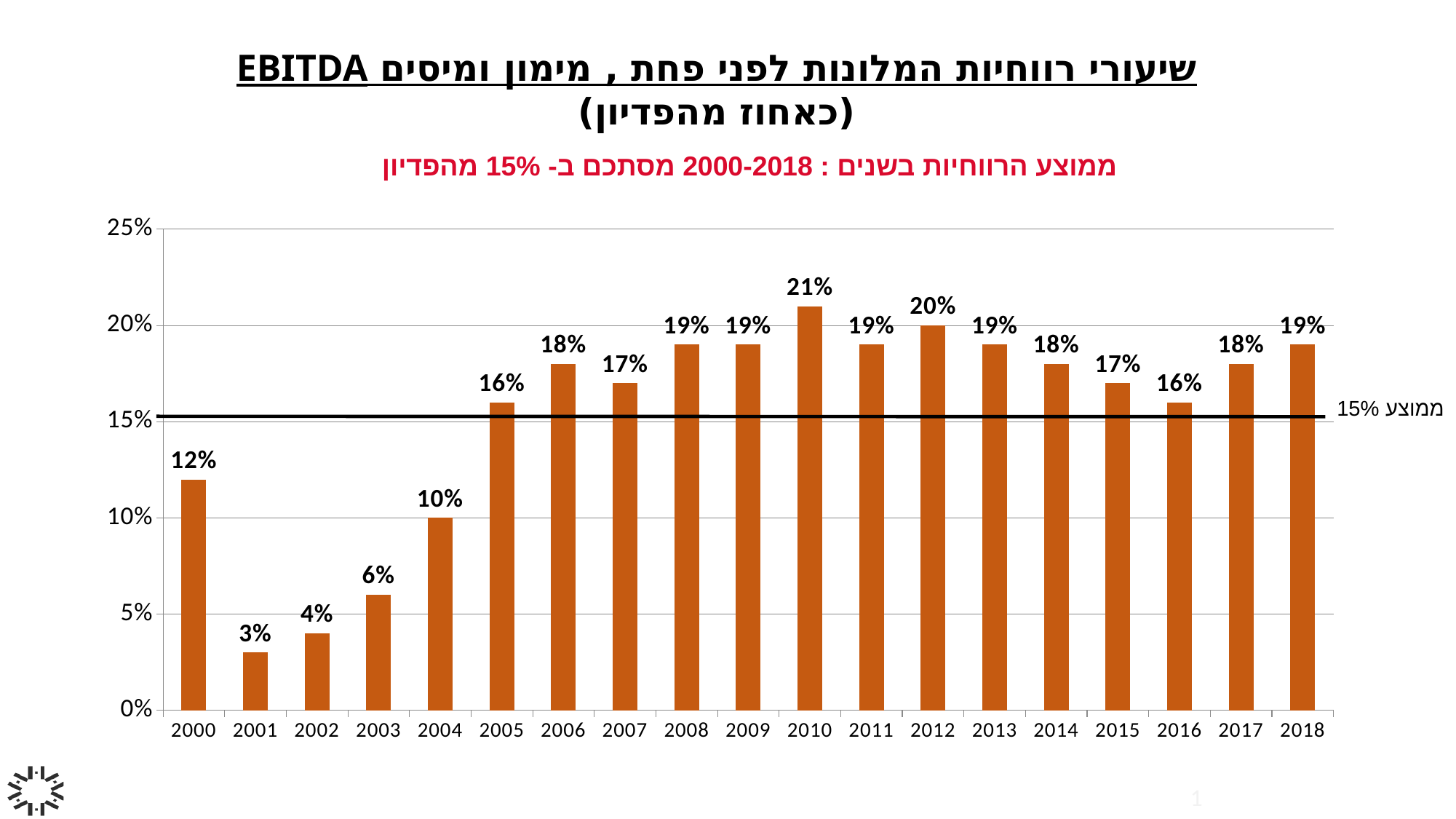
What is the value shown for 2001? 3% What is the value shown for 2018? 19% What kind of chart is shown on the slide? Bar chart Which year has the lowest value in the chart? 2001 Which year has the highest value in the chart? 2010 How many years are shown on the x axis of the chart? 19 What is the difference between the values for 2010 and 2001? 18% Which year has a larger value, 2000 or 2005? 2005 What value does the horizontal average line on the chart mark? 15% What is the difference between the values for 2012 and 2004? 10% What is the EBITDA profitability rate shown for 2010? 21%